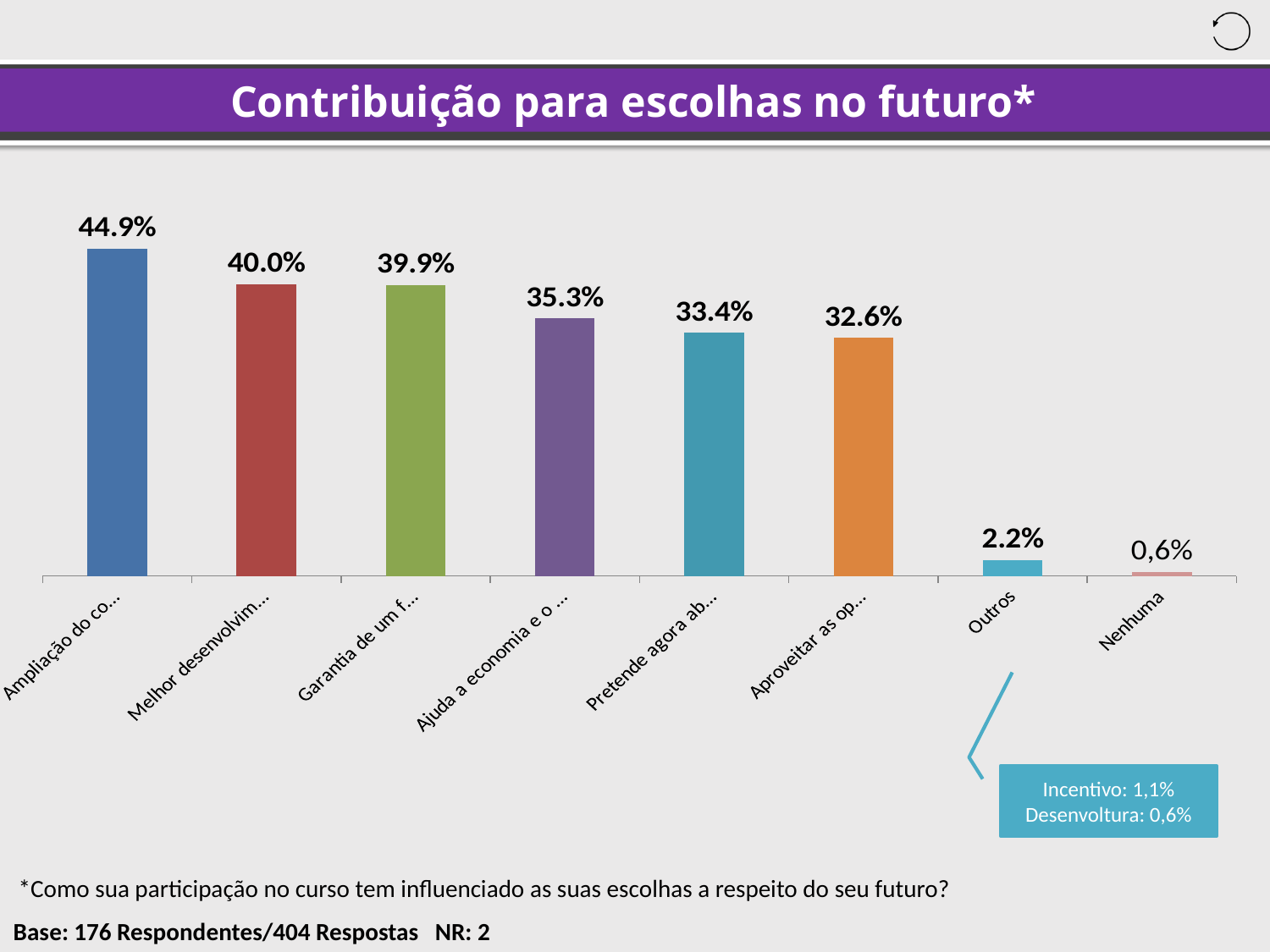
What kind of chart is shown on the slide? Bar chart Which category has the lowest value in the chart? Nenhuma What is the value shown on the first (leftmost) bar, labelled "Ampliação do co..."? 44.9% What is the value shown for the category "Nenhuma"? 0,6% Do the values rise or fall from left to right across the bars? Fall What is the difference in percentage points between the first bar (44.9%) and the second bar (40.0%)? 4.9 percentage points What is the value shown for the category "Outros"? 2.2% What is the value shown on the bar labelled "Aproveitar as op..."? 32.6% Which category has the highest value in the chart? Ampliação do co... (the first bar) How many categories (bars) are shown in the chart? 8 Which has a larger value, "Outros" or "Nenhuma"? Outros What is the difference in percentage points between "Outros" and "Nenhuma"? 1.6 percentage points